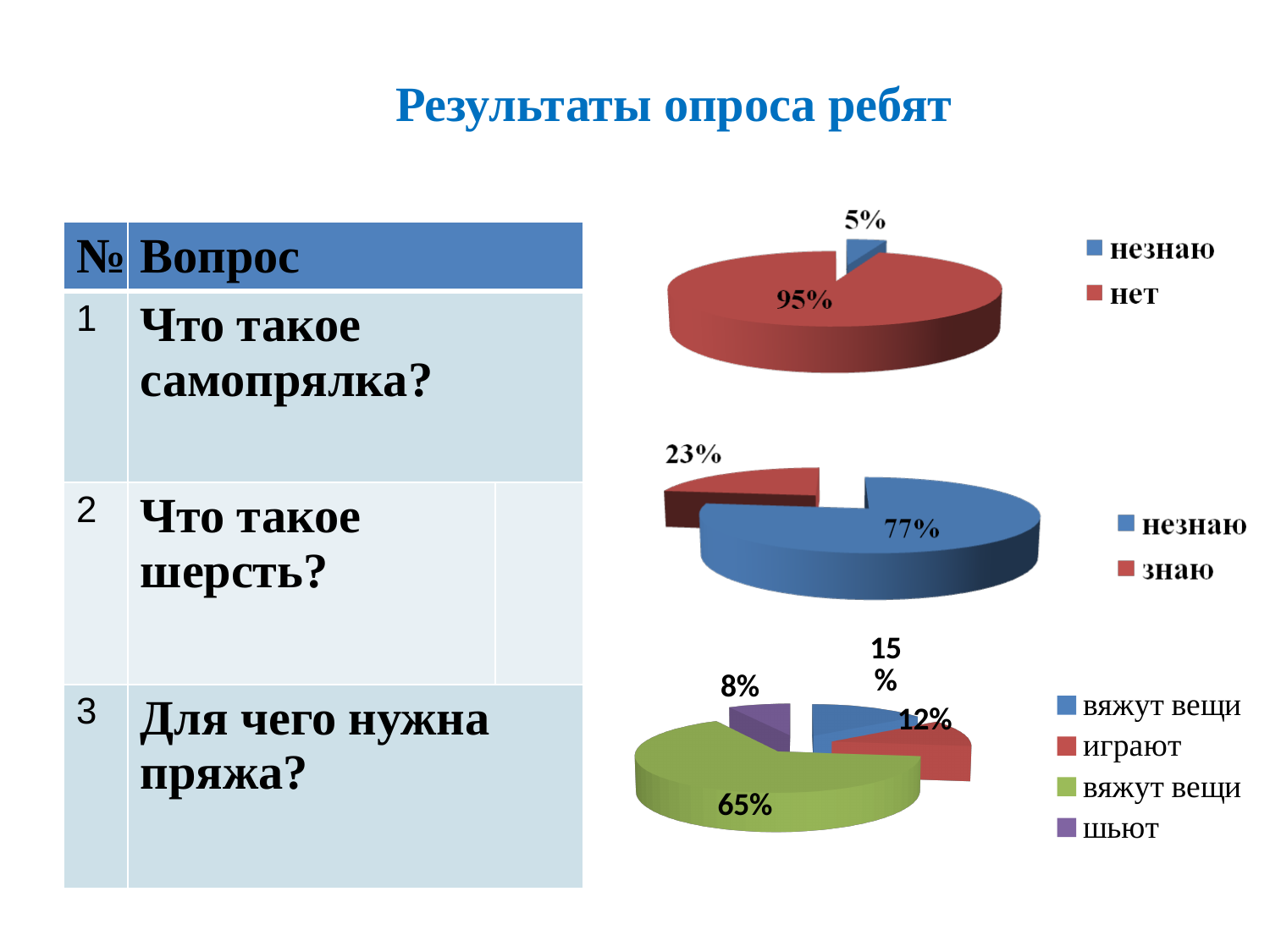
In the middle pie chart, what share is labelled for 'знаю'? 23% What kind of chart is the top chart on the slide? pie chart How many slices does the bottom pie chart have? 4 In the bottom pie chart, what share is labelled for 'играют'? 12% In the bottom pie chart, which slice is the smallest? шьют In the top pie chart, which slice is the largest? нет In the top pie chart, what share is labelled for the 'незнаю' slice? 5% In the top pie chart, what share is labelled for the 'нет' slice? 95% How many entries does the legend of the top pie chart list? 2 In the middle pie chart, which is larger, 'незнаю' or 'знаю'? незнаю In the middle pie chart, what share is labelled for 'незнаю'? 77% In the middle pie chart, what is the difference between the 'незнаю' and 'знаю' shares? 54%